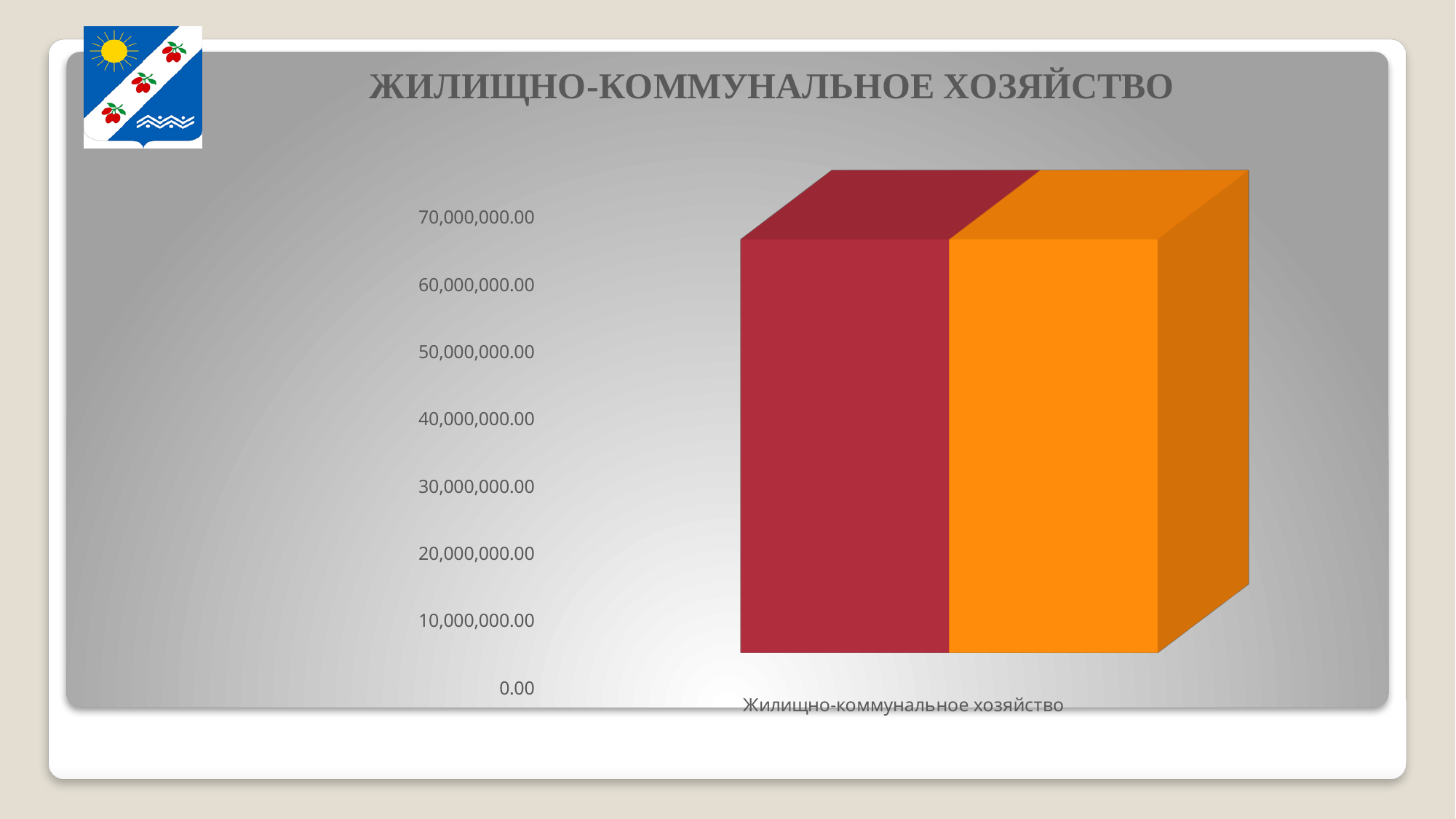
What is the highest tick value shown on the vertical axis? 70,000,000.00 What is the title of the slide? ЖИЛИЩНО-КОММУНАЛЬНОЕ ХОЗЯЙСТВО How many categories are shown on the x axis of the chart? 1 Is the value of the red bar greater or less than 60,000,000.00? greater Is the value of the orange bar greater or less than 70,000,000.00? less What kind of chart is shown on the slide? bar chart Is the value of the orange bar greater or less than 60,000,000.00? greater How many bars are plotted in the chart? 2 What is the category label shown on the x axis? Жилищно-коммунальное хозяйство